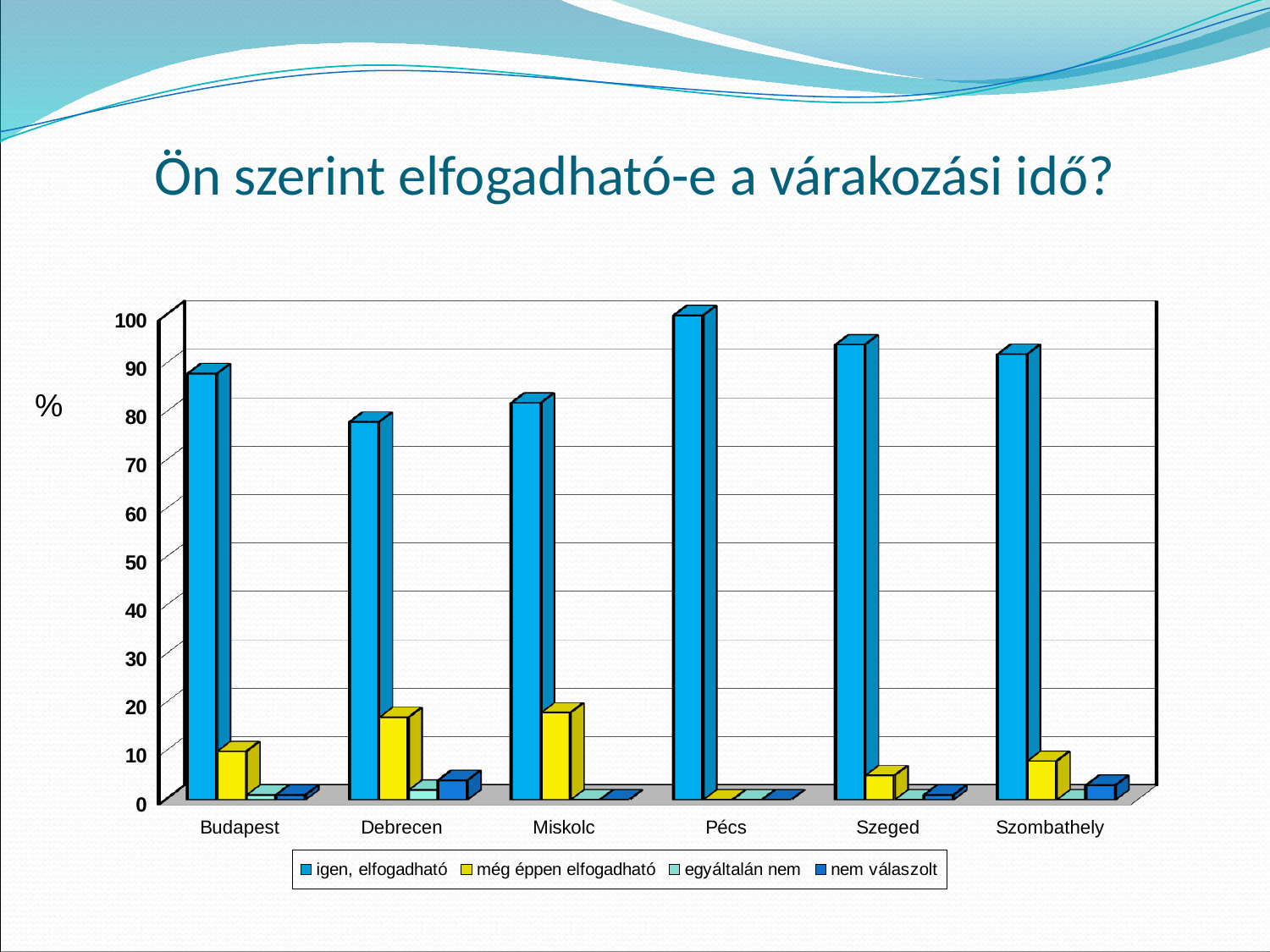
Which city has the lowest value for "még éppen elfogadható"? Pécs How many series does the chart's legend list? 4 Is the value for "igen, elfogadható" in Szeged greater or less than 90? greater How many cities are shown on the x axis of the chart? 6 What kind of chart is shown on the slide? bar chart Which city has the highest value for "igen, elfogadható"? Pécs Which is larger for "még éppen elfogadható": Debrecen or Szeged? Debrecen Is the value for "igen, elfogadható" in Budapest greater or less than 80? greater Which is larger for "igen, elfogadható": Budapest or Debrecen? Budapest Is the value for "még éppen elfogadható" in Budapest greater or less than 20? less What is the title of the chart on the slide? Ön szerint elfogadható-e a várakozási idő?